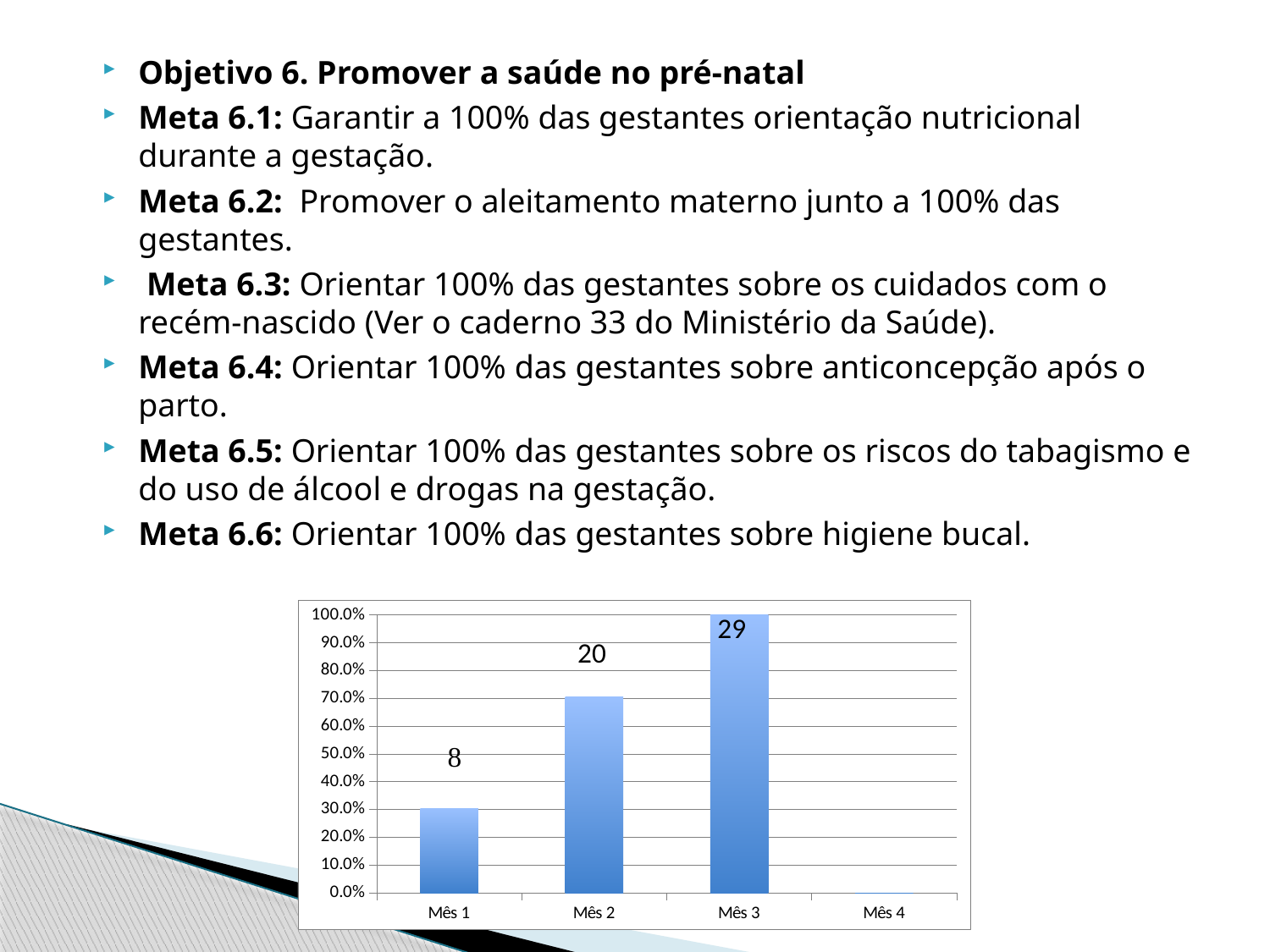
Which month has the tallest bar in the chart? Mês 3 What data label is shown on the bar for Mês 3? 29 How many categories are shown on the x axis of the chart? 4 What is the difference between the data labels for Mês 2 and Mês 1? 12 Which bar is taller, Mês 2 or Mês 3? Mês 3 What is the difference between the data labels for Mês 3 and Mês 1? 21 Is the bar for Mês 1 greater or less than 40.0%? less What data label is shown on the bar for Mês 1? 8 What data label is shown on the bar for Mês 2? 20 Which of Mês 1 and Mês 2 has the shorter bar? Mês 1 Is the bar for Mês 2 greater or less than 60.0%? greater What kind of chart is shown on the slide? bar chart